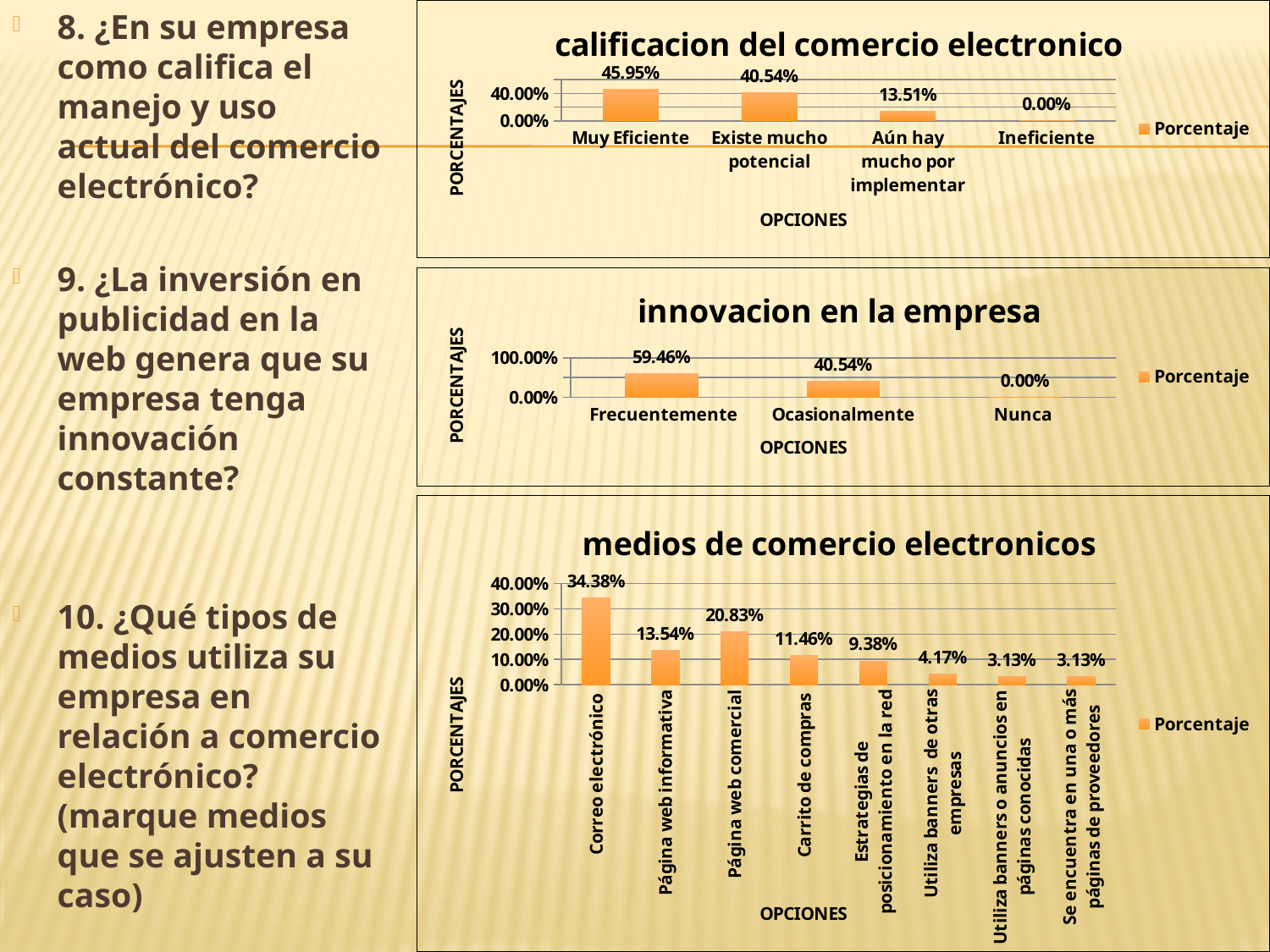
In the chart titled "medios de comercio electronicos", is the value for "Página web comercial" greater or less than 30.00%? less In the chart titled "calificacion del comercio electronico", which category has the lowest value? Ineficiente In the chart titled "innovacion en la empresa", what is the value for "Frecuentemente"? 59.46% In the chart titled "innovacion en la empresa", which is larger, "Frecuentemente" or "Ocasionalmente"? Frecuentemente In the chart titled "calificacion del comercio electronico", what is the value for "Muy Eficiente"? 45.95% In the chart titled "medios de comercio electronicos", how many categories are shown on the x axis? 8 In the chart titled "calificacion del comercio electronico", how many categories are shown on the x axis? 4 In the chart titled "calificacion del comercio electronico", what is the difference between "Muy Eficiente" and "Existe mucho potencial"? 5.41% In the chart titled "innovacion en la empresa", what is the difference between "Frecuentemente" and "Ocasionalmente"? 18.92% In the chart titled "medios de comercio electronicos", what is the value for "Carrito de compras"? 11.46% In the chart titled "medios de comercio electronicos", which category has the highest value? Correo electrónico What kind of chart is the chart titled "medios de comercio electronicos"? Bar chart